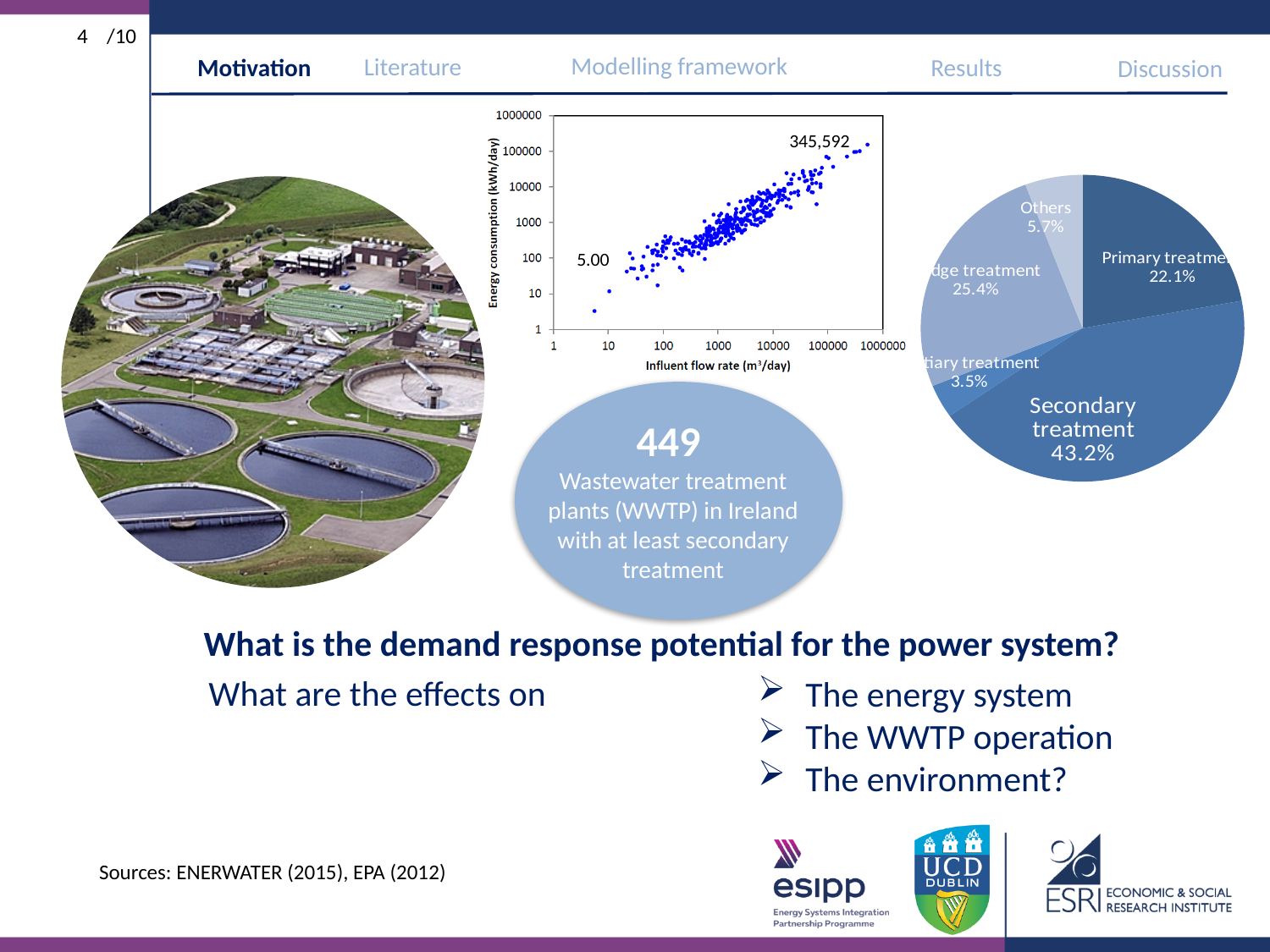
In the scatter chart, what is the lowest labelled value? 5.00 In the pie chart, what share does Secondary treatment have? 43.2% What kind of chart is the chart on the right of the slide showing treatment types? pie chart In the pie chart, what is the value shown for Primary treatment? 22.1% In the pie chart, which slice is the largest? Secondary treatment What kind of chart is the chart in the top centre of the slide plotting energy consumption against influent flow rate? scatter chart In the pie chart, what is the value shown for Others? 5.7% In the pie chart, what is the difference between the Secondary treatment share and the Primary treatment share? 21.1% In the pie chart, which is larger, Primary treatment or Others? Primary treatment In the scatter chart, does energy consumption rise or fall as influent flow rate increases? rise In the scatter chart, what is the highest labelled energy consumption value? 345,592 What is the x-axis title of the scatter chart? Influent flow rate (m³/day)